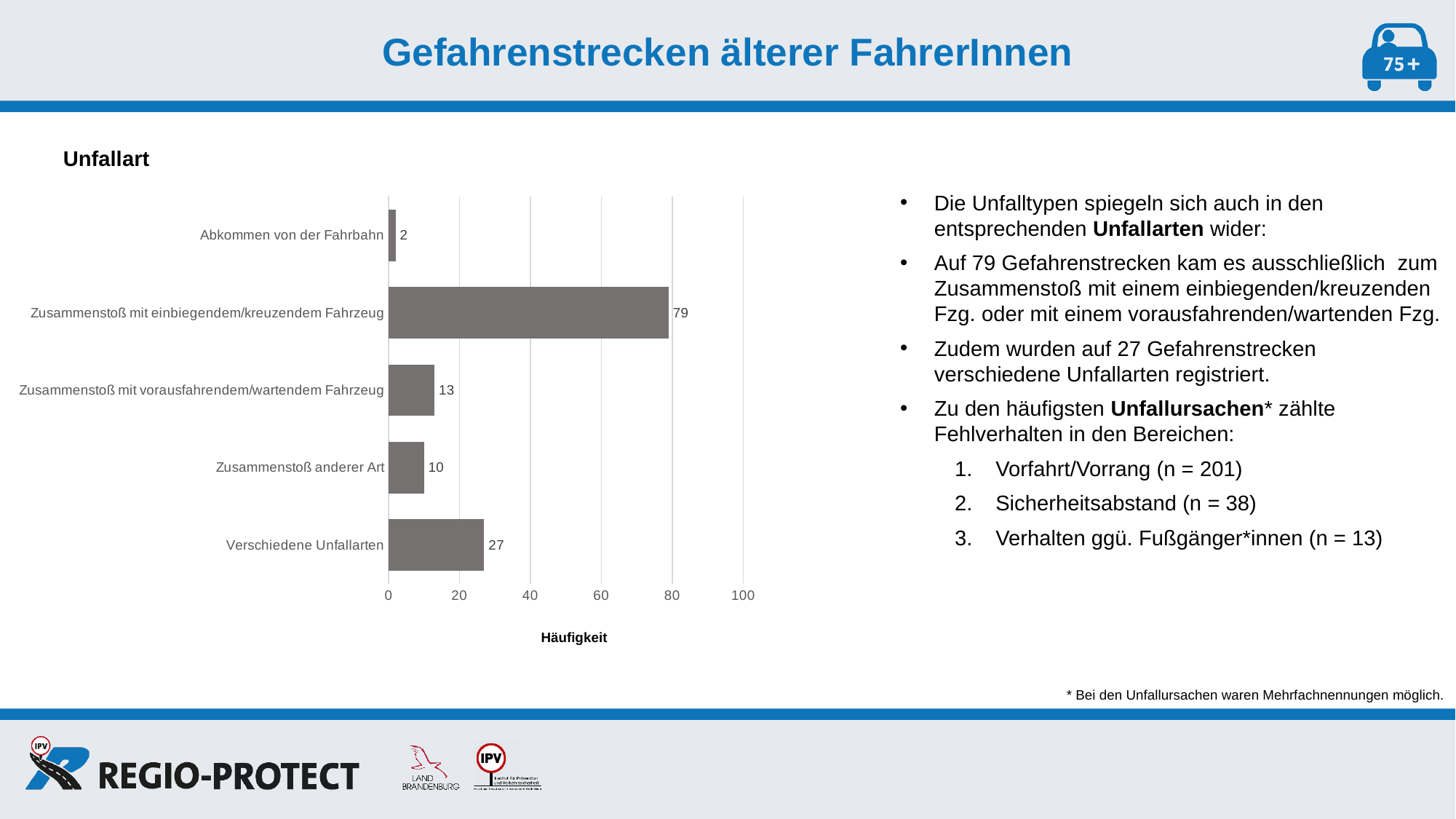
Which category has the lowest value? Abkommen von der Fahrbahn What is the value for "Verschiedene Unfallarten"? 27 What is the value for "Abkommen von der Fahrbahn"? 2 How many categories are shown in the chart? 5 What kind of chart is shown on the slide? Bar chart What is the value for "Zusammenstoß mit einbiegendem/kreuzendem Fahrzeug"? 79 Which category has the highest value? Zusammenstoß mit einbiegendem/kreuzendem Fahrzeug What is the value for "Zusammenstoß anderer Art"? 10 Is the value for "Zusammenstoß mit einbiegendem/kreuzendem Fahrzeug" greater or less than 60? greater What is the difference between the values for "Zusammenstoß mit einbiegendem/kreuzendem Fahrzeug" and "Verschiedene Unfallarten"? 52 What is the label of the horizontal axis of the chart? Häufigkeit Which is larger: the value for "Zusammenstoß mit vorausfahrendem/wartendem Fahrzeug" or "Zusammenstoß anderer Art"? Zusammenstoß mit vorausfahrendem/wartendem Fahrzeug